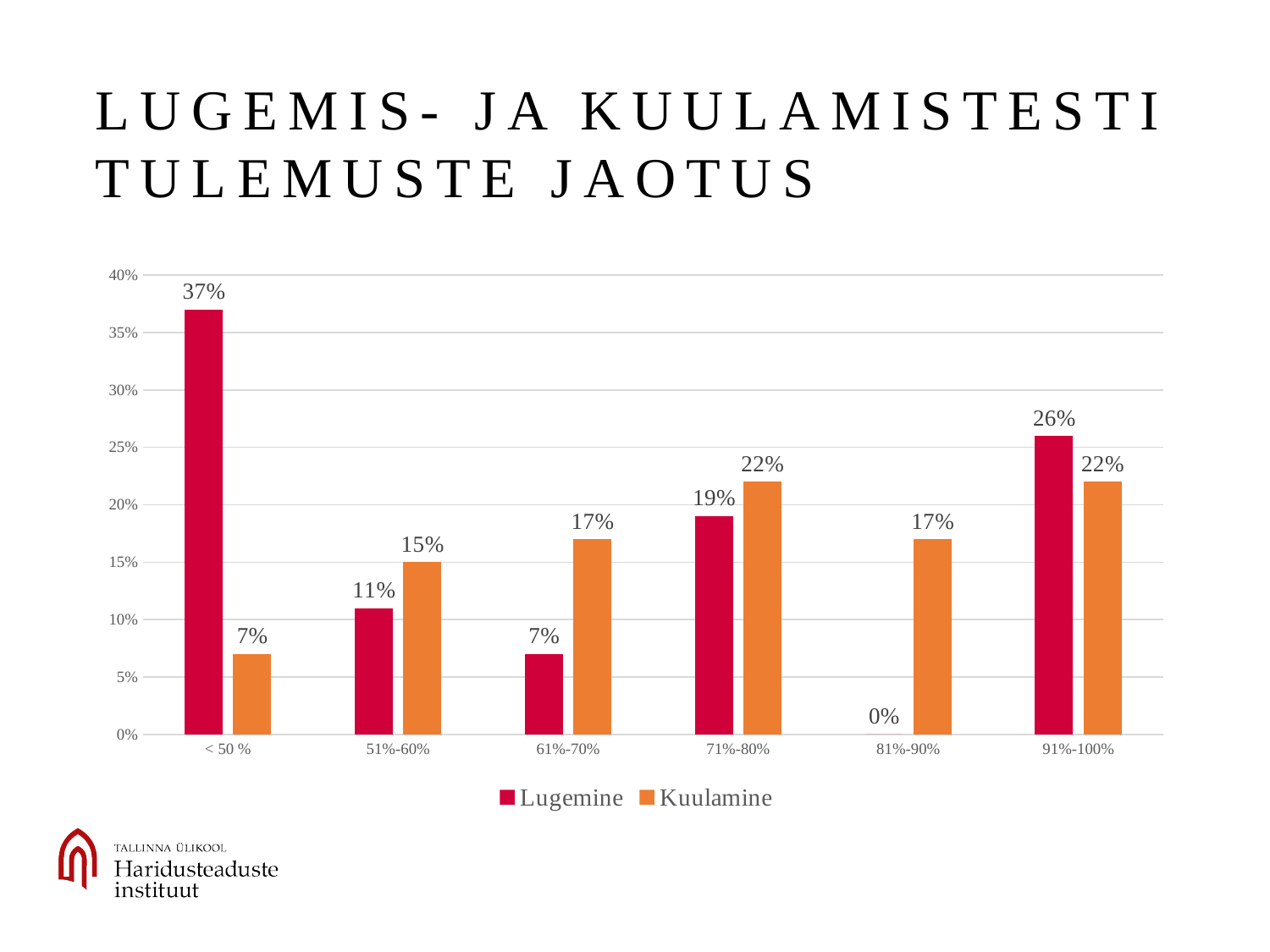
What kind of chart is shown on the slide? Bar chart What is the Kuulamine value for the 61%-70% category? 17% What is the Lugemine value for the 81%-90% category? 0% How many categories are shown on the x axis? 6 Which category has the highest Lugemine value? < 50 % What is the difference between the Lugemine and Kuulamine values for the < 50 % category? 30% Which is larger for the 91%-100% category, Lugemine or Kuulamine? Lugemine What is the Lugemine value for the < 50 % category? 37% Which colour represents the Kuulamine series? Orange How many series does the legend list? 2 Which category has the lowest Kuulamine value? < 50 % What is the difference between the Kuulamine and Lugemine values for the 61%-70% category? 10%